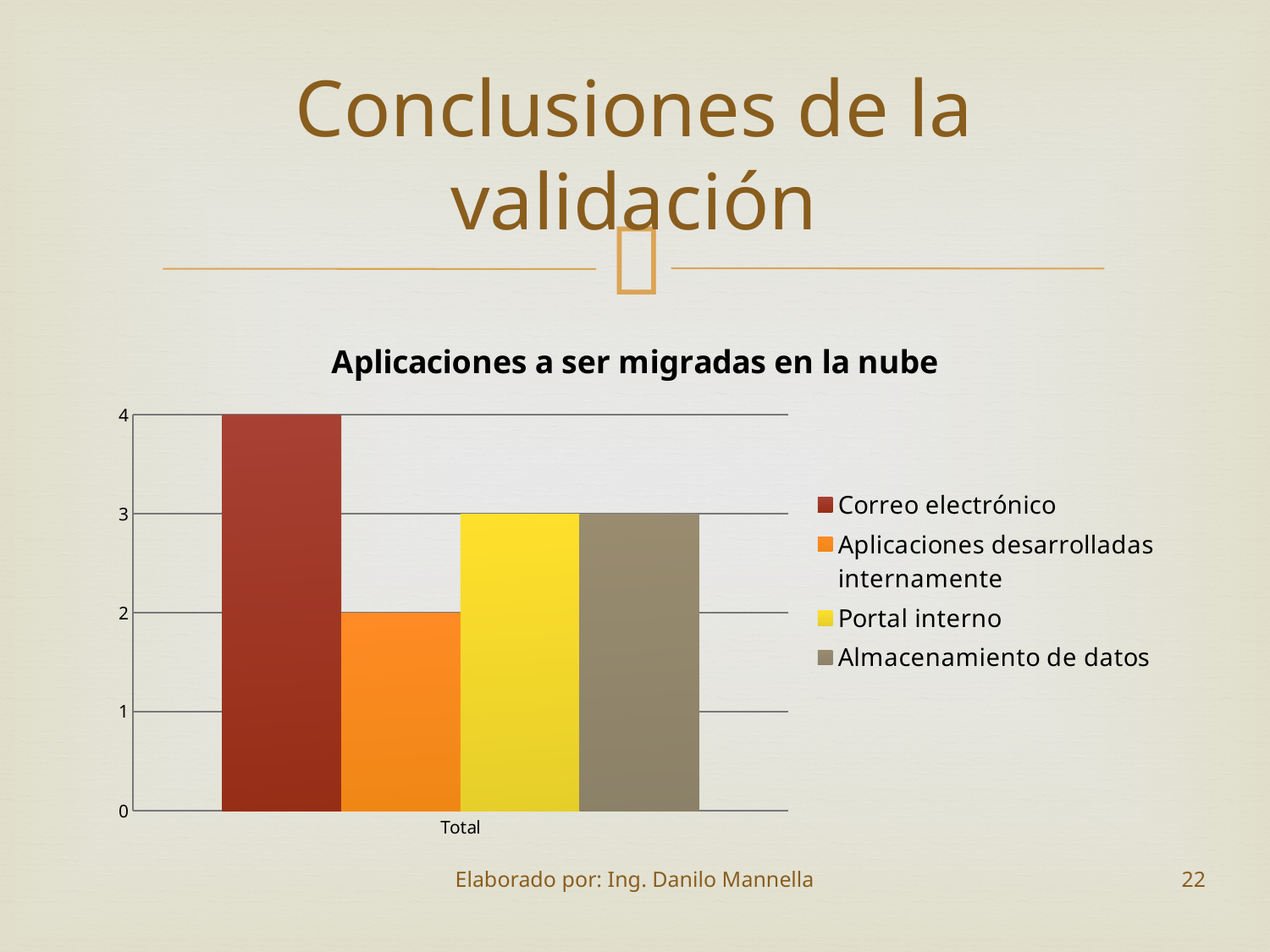
Which is larger, the value for Correo electrónico or the value for Portal interno? Correo electrónico What kind of chart is shown on the slide? Bar chart What is the value for Portal interno? 3 Which series has the lowest value? Aplicaciones desarrolladas internamente What is the value for Correo electrónico? 4 Which series has the highest value? Correo electrónico What is the value for Almacenamiento de datos? 3 How many series does the legend list? 4 What is the difference between the values for Correo electrónico and Aplicaciones desarrolladas internamente? 2 What is the value for Aplicaciones desarrolladas internamente? 2 Is the value for Aplicaciones desarrolladas internamente greater or less than 3? less What is the title of the chart? Aplicaciones a ser migradas en la nube